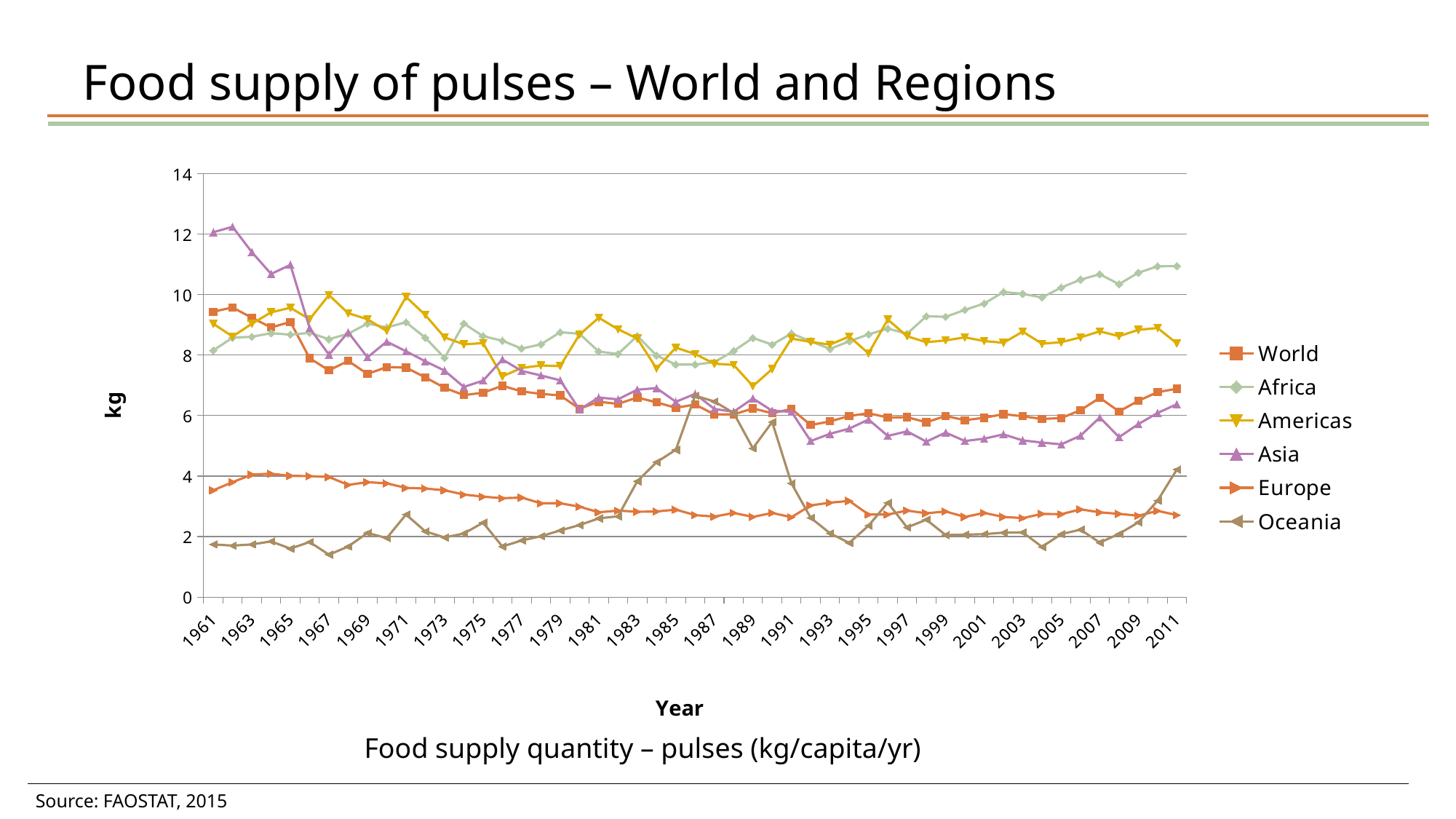
Which series has the highest value in 2011? Africa What is the label on the vertical axis? kg What kind of chart is shown on the slide? Line chart How many series does the legend list? 6 Which series has the lowest value in 1961? Oceania In 2011, which is larger: the value for Africa or the value for Asia? Africa Which series has the lowest value in 2011? Europe In 1961, which is larger: the value for Europe or the value for Oceania? Europe Is the value for Asia in 1961 greater or less than 10? greater Is the value for Oceania in 1967 greater or less than 2? less Is the value for Africa in 2011 greater or less than 10? greater Does the value for Asia rise or fall overall from 1961 to 2011? fall